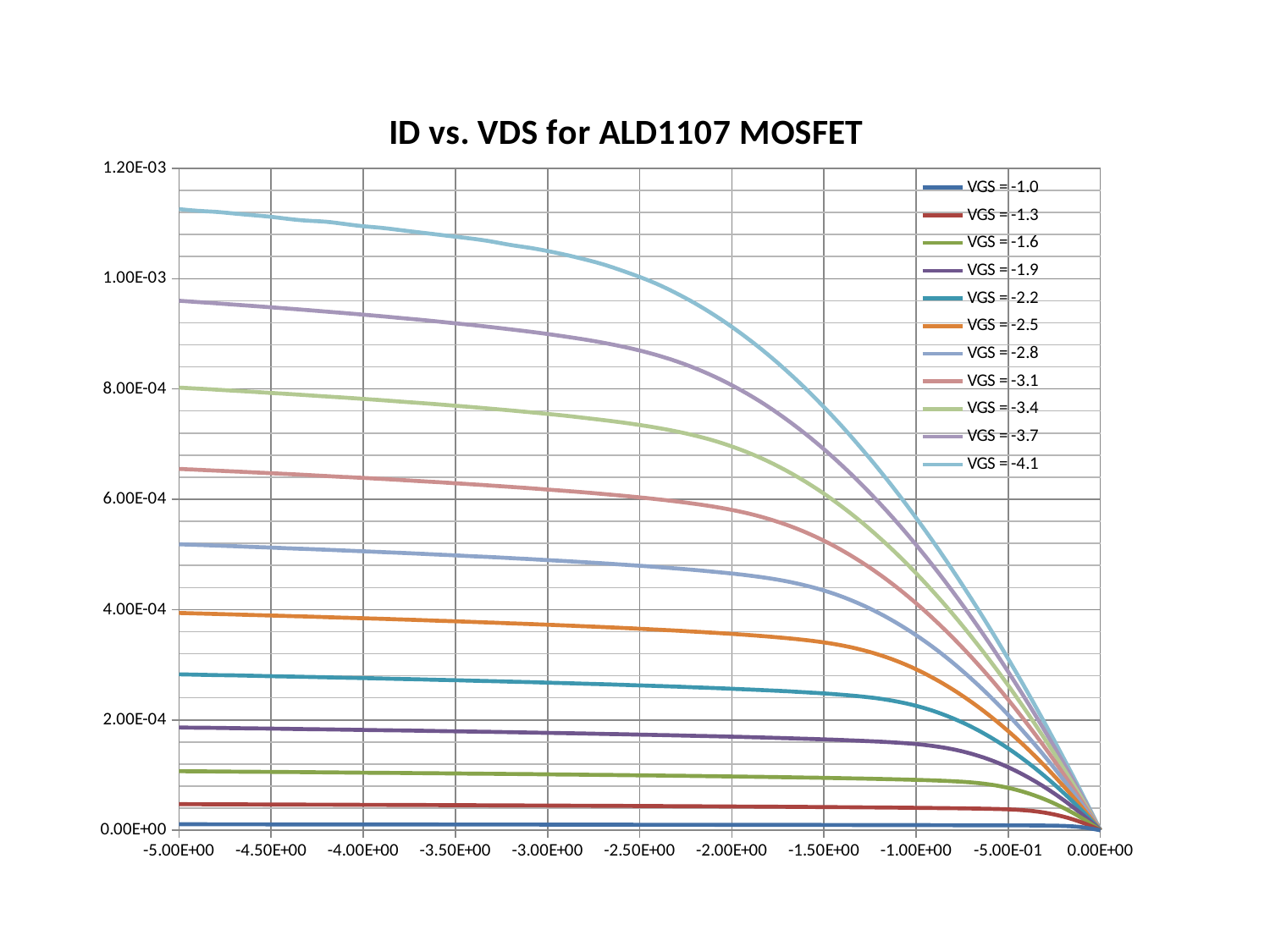
Is the ID value for VGS = -3.7 at VDS = -5.00E+00 greater or less than 1.00E-03? less Is the ID value for VGS = -2.8 at VDS = -5.00E+00 greater or less than 6.00E-04? less Which series has the highest ID at VDS = -5.00E+00? VGS = -4.1 Is the ID value for VGS = -4.1 at VDS = -5.00E+00 greater or less than 1.00E-03? greater Which series has the lowest ID at VDS = -5.00E+00? VGS = -1.0 Moving left to right along the x axis from -5.00E+00 to 0.00E+00, do the ID values rise or fall? fall At VDS = -5.00E+00, which series has the larger ID: VGS = -3.1 or VGS = -2.5? VGS = -3.1 How many series does the legend list? 11 What kind of chart is shown on the slide? line chart What is the title of the chart? ID vs. VDS for ALD1107 MOSFET What ID value do all the series reach at VDS = 0.00E+00? 0.00E+00